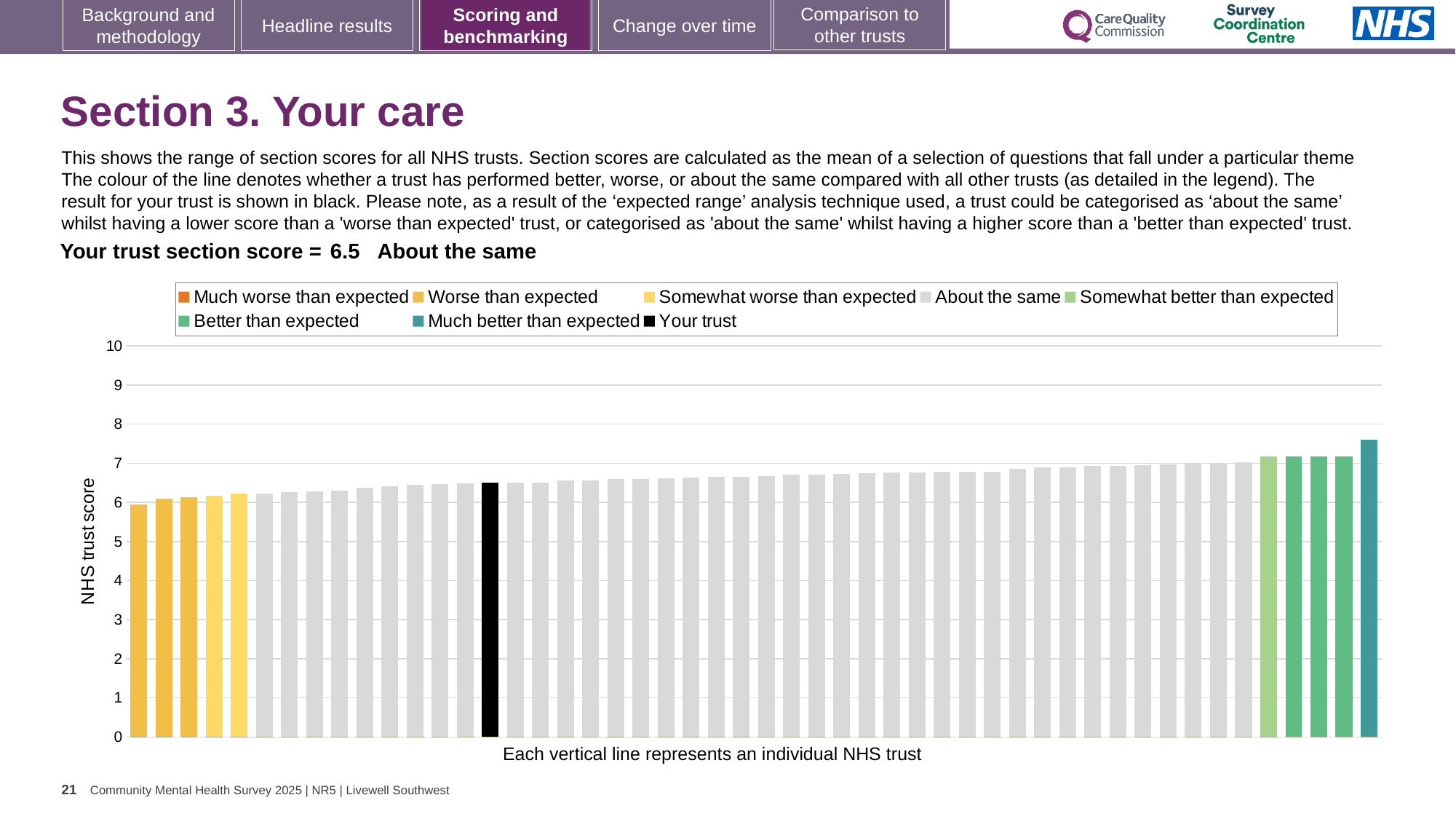
What kind of chart is shown on the slide? Bar chart How many bars are coloured as 'Much better than expected'? 1 How many entries does the chart legend list? 8 Which legend category does the highest bar on the chart belong to? Much better than expected What does each vertical line on the chart represent, according to the caption below the x axis? An individual NHS trust Do the bar values rise or fall from left to right along the x axis? Rise Is the value of the leftmost (lowest) bar greater or less than 5? greater Is the value of the tallest bar (the 'Much better than expected' bar) greater or less than 7? greater What is the section score for your trust shown on the chart? 6.5 Which category is your trust placed in for this section? About the same What is the label on the vertical axis of the chart? NHS trust score Is the value of the black 'Your trust' bar greater or less than 6? greater